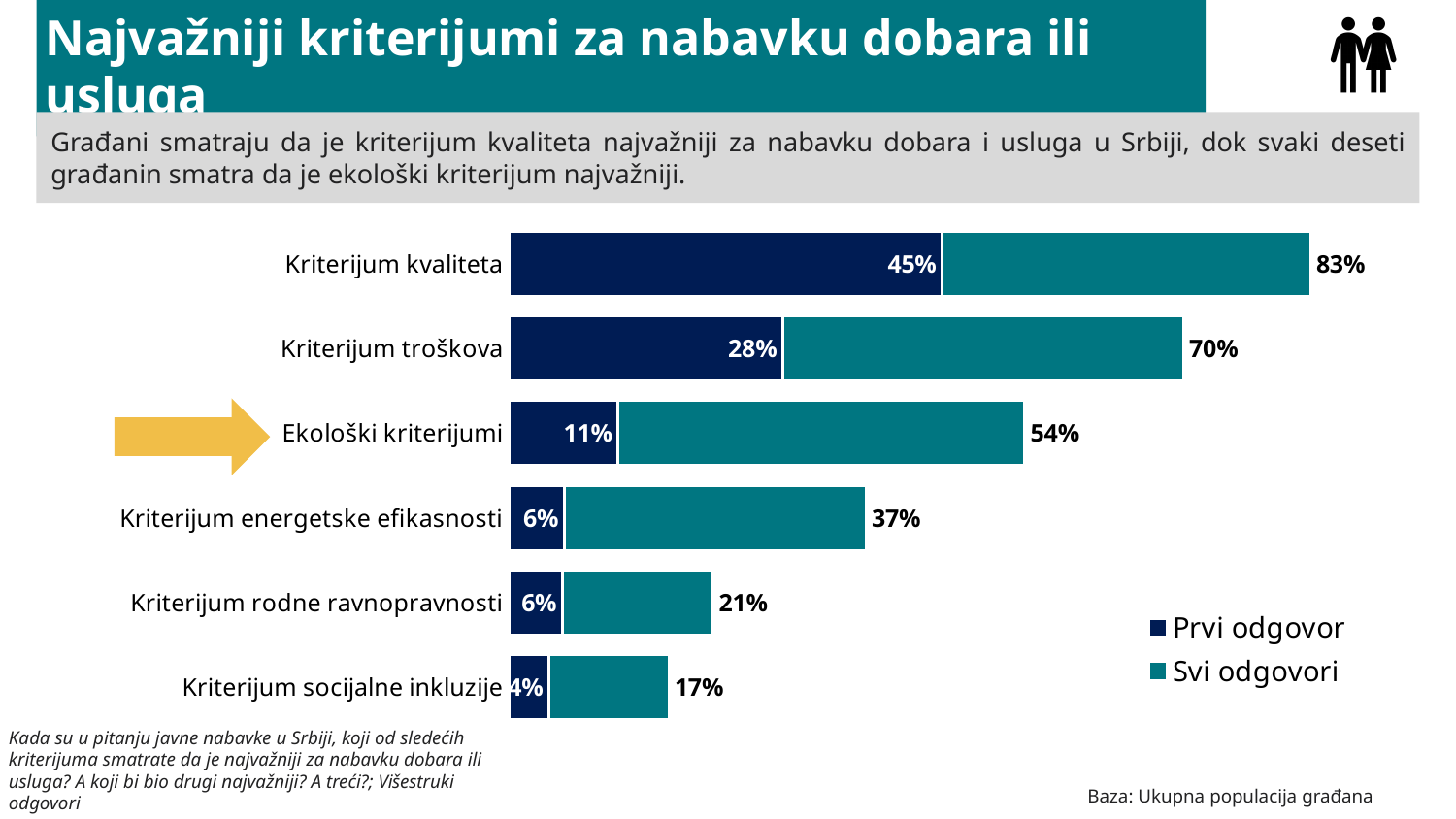
What is the difference between the 'Prvi odgovor' and 'Svi odgovori' values for Ekološki kriterijumi? 43% How many categories are shown in the chart? 6 What is the 'Prvi odgovor' value for Kriterijum socijalne inkluzije? 4% Which category has the highest 'Svi odgovori' value? Kriterijum kvaliteta What is the 'Svi odgovori' value for Ekološki kriterijumi? 54% What kind of chart is shown on the slide? Bar chart Which is larger: the 'Svi odgovori' value for Kriterijum energetske efikasnosti or for Kriterijum rodne ravnopravnosti? Kriterijum energetske efikasnosti What is the 'Prvi odgovor' value for Kriterijum troškova? 28% What is the difference between the 'Svi odgovori' values for Kriterijum kvaliteta and Kriterijum troškova? 13% What is the 'Svi odgovori' value for Kriterijum kvaliteta? 83% How many series does the legend list? 2 Which category has the lowest 'Prvi odgovor' value? Kriterijum socijalne inkluzije